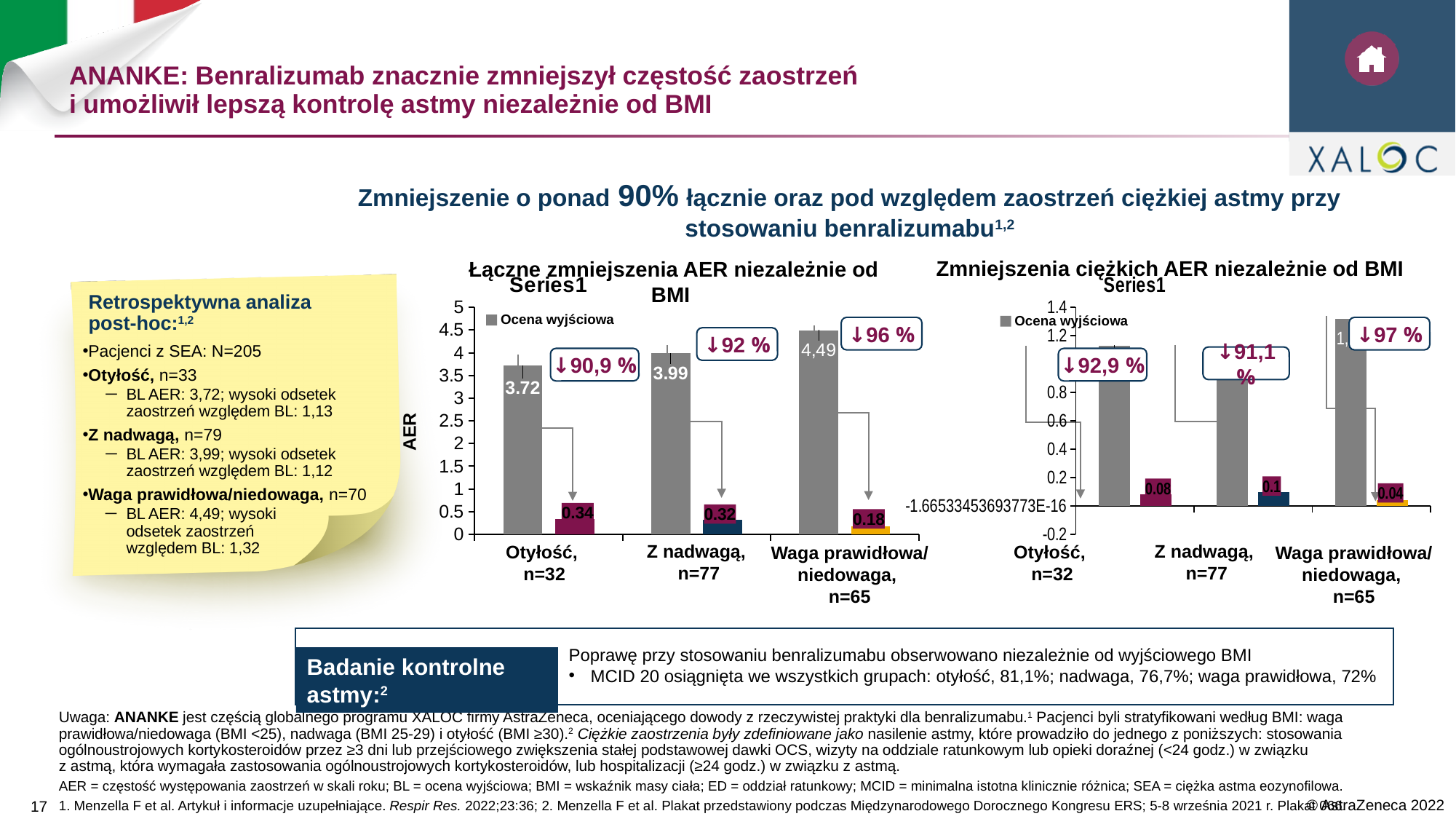
In the chart 'Zmniejszenia ciężkich AER niezależnie od BMI', what percentage reduction is shown for 'Otyłość, n=32'? 92,9 % In the chart 'Łączne zmniejszenia AER niezależnie od BMI', what is the follow-up AER value for 'Z nadwagą, n=77'? 0.32 In the chart 'Łączne zmniejszenia AER niezależnie od BMI', what is the baseline (Ocena wyjściowa) AER value for 'Otyłość, n=32'? 3.72 In the chart 'Łączne zmniejszenia AER niezależnie od BMI', what is the difference between the baseline and follow-up AER for 'Otyłość, n=32'? 3.38 In the chart 'Łączne zmniejszenia AER niezależnie od BMI', which category has the highest baseline AER? Waga prawidłowa/niedowaga, n=65 In the chart 'Zmniejszenia ciężkich AER niezależnie od BMI', what is the follow-up severe AER value for 'Otyłość, n=32'? 0.08 In the chart 'Łączne zmniejszenia AER niezależnie od BMI', which category has the lowest follow-up AER value? Waga prawidłowa/niedowaga, n=65 In the chart 'Zmniejszenia ciężkich AER niezależnie od BMI', what is the follow-up severe AER value for 'Waga prawidłowa/niedowaga, n=65'? 0.04 How many categories are shown on the x axis of the chart 'Zmniejszenia ciężkich AER niezależnie od BMI'? 3 What type of chart is 'Łączne zmniejszenia AER niezależnie od BMI'? Bar chart In the chart 'Łączne zmniejszenia AER niezależnie od BMI', what percentage reduction is shown for 'Z nadwagą, n=77'? 92 % In the chart 'Łączne zmniejszenia AER niezależnie od BMI', what is the baseline AER value for 'Waga prawidłowa/niedowaga, n=65'? 4,49